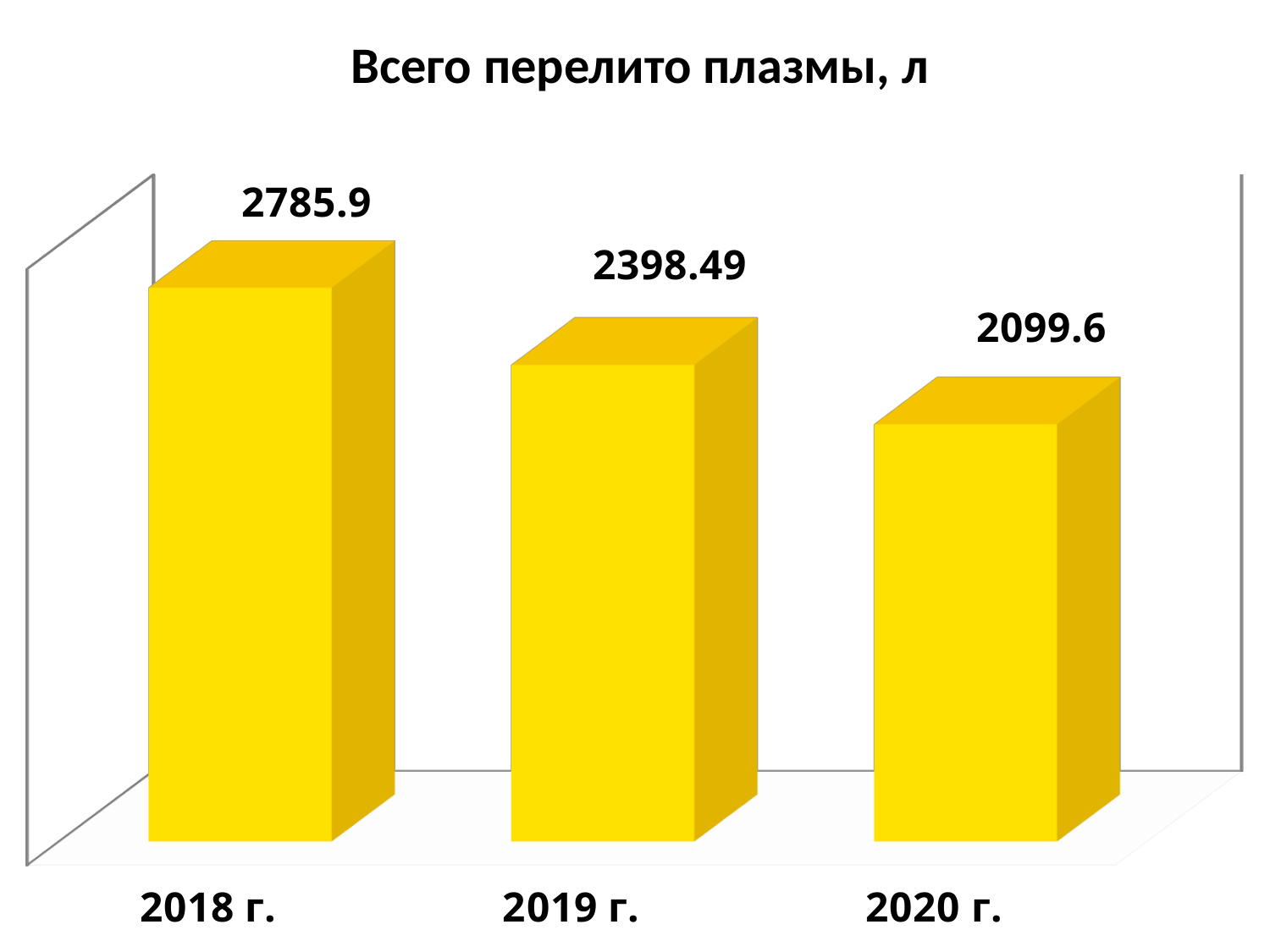
What is the difference between the values for 2019 г. and 2020 г.? 298.89 What is the difference between the values for 2018 г. and 2019 г.? 387.41 Which year has the highest value? 2018 г. What is the difference between the values for 2018 г. and 2020 г.? 686.3 How many years are shown on the chart? 3 Do the values rise or fall from 2018 г. to 2020 г.? fall Which is larger, the value for 2019 г. or the value for 2020 г.? 2019 г. What is the value for 2020 г.? 2099.6 What kind of chart is shown on the slide? bar chart What is the value for 2019 г.? 2398.49 Which year has the lowest value? 2020 г. What is the value for 2018 г.? 2785.9